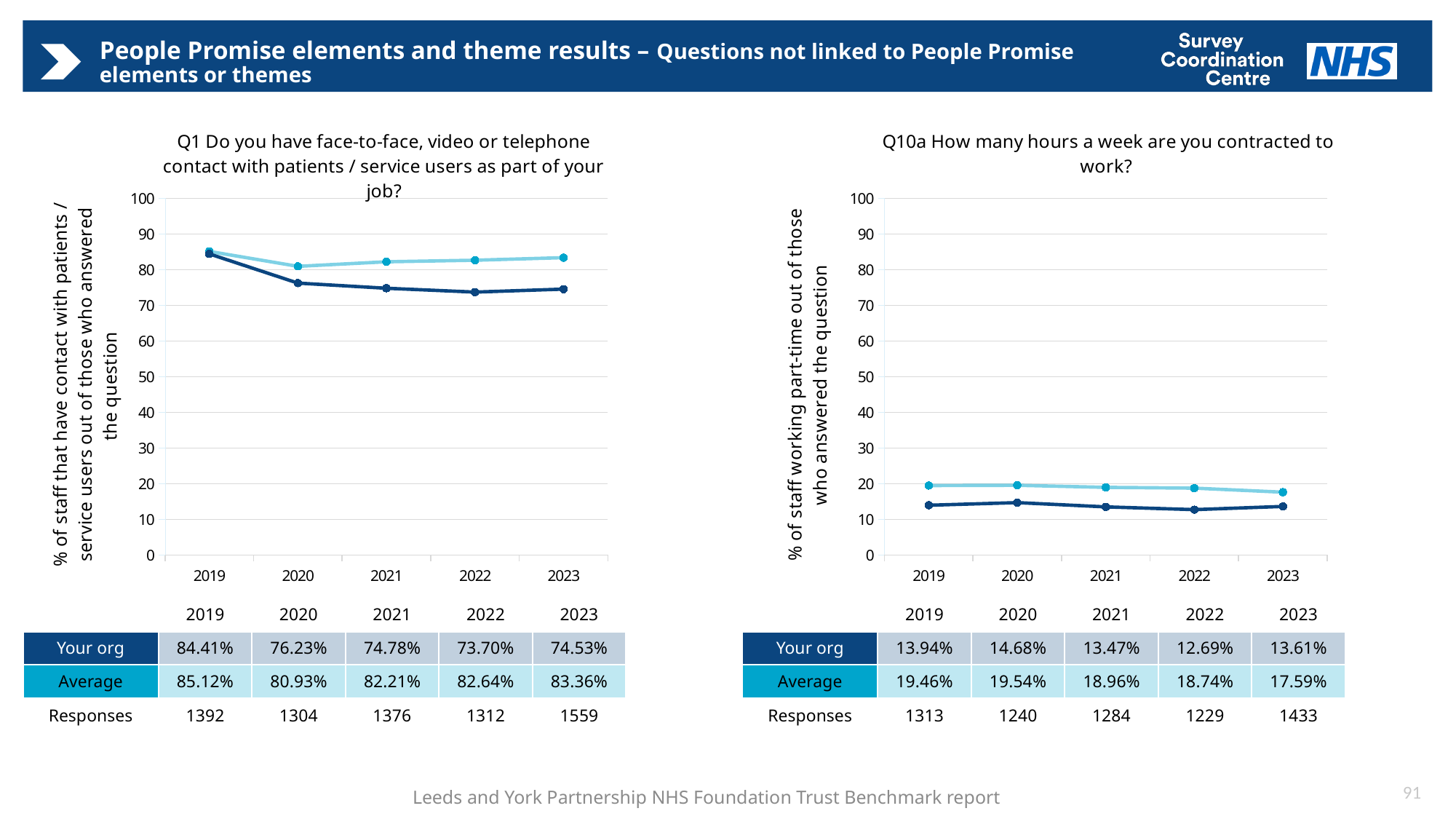
In the Q10a chart (hours a week contracted to work), does the Average line rise or fall from 2020 to 2023? Fall In the Q10a chart (hours a week contracted to work), which year had the highest Average value? 2020 In the Q1 chart (face-to-face, video or telephone contact with patients), what is the difference between the Average and Your org values in 2021? 7.43% In the Q10a chart (hours a week contracted to work), is the Average value in 2019 greater or less than 20? less In the Q10a chart (hours a week contracted to work), how many responses were there in 2023? 1433 In the Q1 chart (face-to-face, video or telephone contact with patients), what kind of chart is shown? Line chart In the Q1 chart (face-to-face, video or telephone contact with patients), what was the value for Your org in 2019? 84.41% In the Q1 chart (face-to-face, video or telephone contact with patients), what was the Average value in 2023? 83.36% In the Q10a chart (hours a week contracted to work), what was the Average value in 2022? 18.74% In the Q10a chart (hours a week contracted to work), what was the value for Your org in 2020? 14.68% In the Q1 chart (face-to-face, video or telephone contact with patients), how many years are plotted on the x axis? 5 In the Q1 chart (face-to-face, video or telephone contact with patients), which year had the lowest value for Your org? 2022